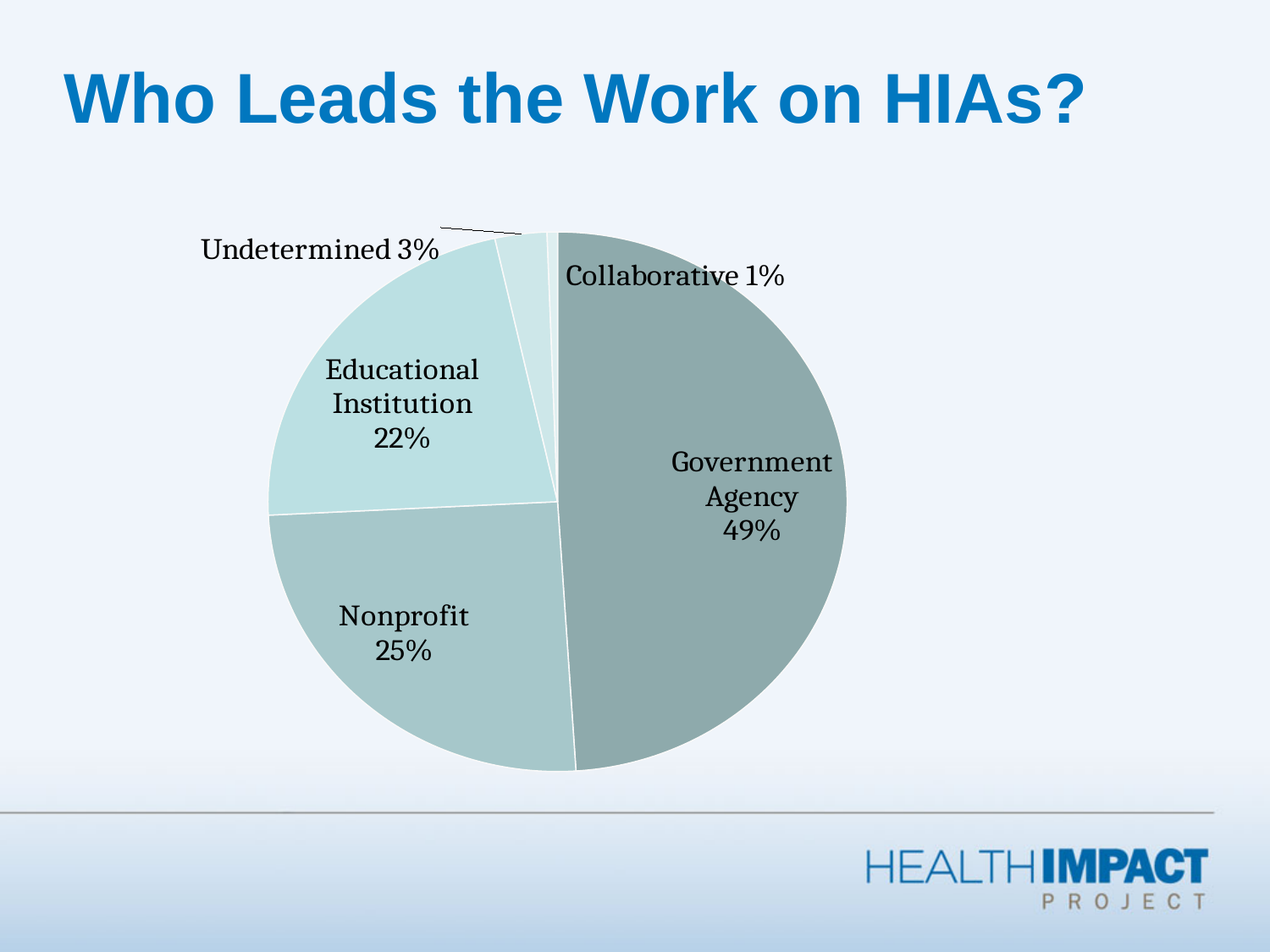
What share of the pie is Collaborative? 1% What percentage is labelled Undetermined? 3% How many categories are shown in the pie chart? 5 What percentage of the pie is labelled Nonprofit? 25% Which category has the largest slice of the pie? Government Agency Which category has the smallest slice of the pie? Collaborative Which is larger, the Nonprofit slice or the Educational Institution slice? Nonprofit What is the difference in percentage points between Nonprofit and Educational Institution? 3 What type of chart is shown on the slide? Pie chart What share of HIAs are led by a Government Agency? 49% What share is shown for Educational Institution? 22% How many percentage points larger is the Government Agency share than the Nonprofit share? 24